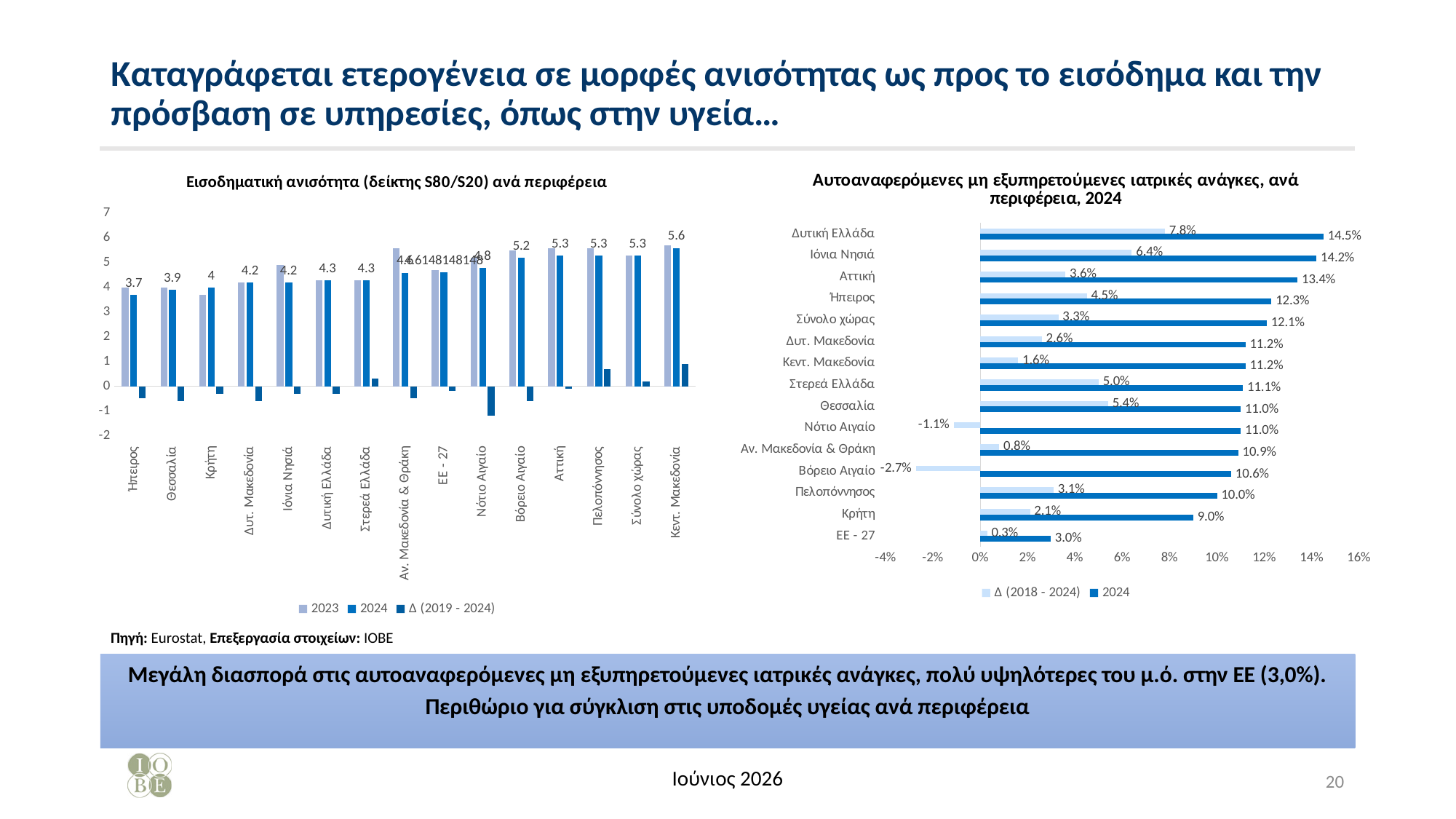
In the chart 'Εισοδηματική ανισότητα (δείκτης S80/S20) ανά περιφέρεια', what is the 2024 value for Κεντ. Μακεδονία? 5.6 In the chart 'Αυτοαναφερόμενες μη εξυπηρετούμενες ιατρικές ανάγκες, ανά περιφέρεια, 2024', what is the difference between the 2024 values for Ιόνια Νησιά and Κρήτη? 5.2% In the chart 'Αυτοαναφερόμενες μη εξυπηρετούμενες ιατρικές ανάγκες, ανά περιφέρεια, 2024', what is the Δ (2018 - 2024) value for Βόρειο Αιγαίο? -2.7% In the chart 'Αυτοαναφερόμενες μη εξυπηρετούμενες ιατρικές ανάγκες, ανά περιφέρεια, 2024', which category has the lowest 2024 value? ΕΕ - 27 In the chart 'Αυτοαναφερόμενες μη εξυπηρετούμενες ιατρικές ανάγκες, ανά περιφέρεια, 2024', which has the larger Δ (2018 - 2024) value, Θεσσαλία or Αττική? Θεσσαλία In the chart 'Αυτοαναφερόμενες μη εξυπηρετούμενες ιατρικές ανάγκες, ανά περιφέρεια, 2024', what is the 2024 value for Δυτική Ελλάδα? 14.5% What kind of chart is 'Εισοδηματική ανισότητα (δείκτης S80/S20) ανά περιφέρεια'? Bar chart In the chart 'Εισοδηματική ανισότητα (δείκτης S80/S20) ανά περιφέρεια', how many series does the legend list? 3 In the chart 'Αυτοαναφερόμενες μη εξυπηρετούμενες ιατρικές ανάγκες, ανά περιφέρεια, 2024', which region has the highest 2024 value? Δυτική Ελλάδα In the chart 'Εισοδηματική ανισότητα (δείκτης S80/S20) ανά περιφέρεια', what is the 2024 value for Ήπειρος? 3.7 How many series does the legend of the chart 'Αυτοαναφερόμενες μη εξυπηρετούμενες ιατρικές ανάγκες, ανά περιφέρεια, 2024' list? 2 In the chart 'Εισοδηματική ανισότητα (δείκτης S80/S20) ανά περιφέρεια', how many categories are shown on the x axis? 15